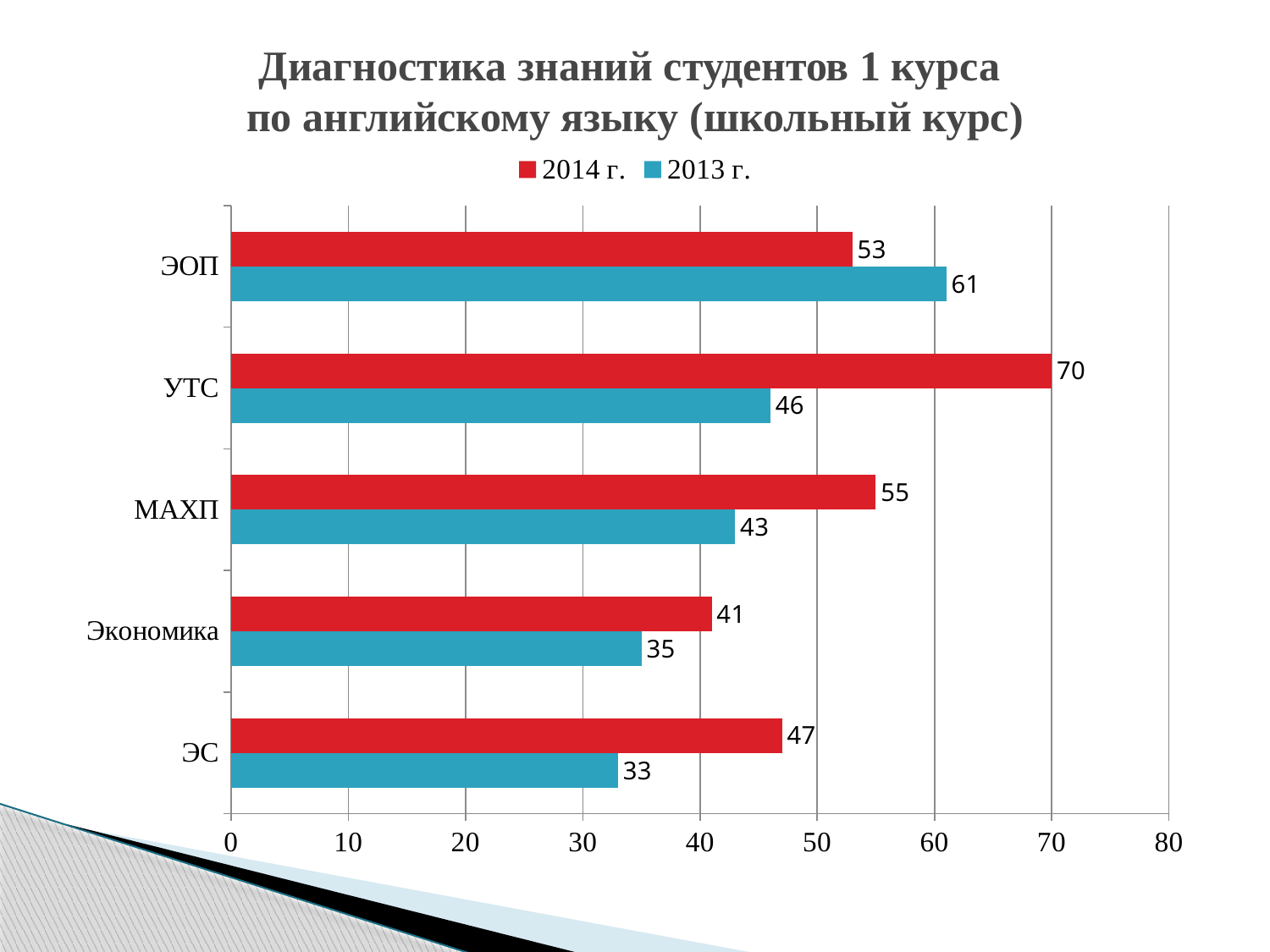
What kind of chart is shown on the slide? bar chart How many categories are shown on the chart? 5 Is the value for МАХП in the 2014 г. series greater or less than 50? greater What is the difference between the 2014 г. and 2013 г. values for УТС? 24 Which is larger for ЭОП: the 2014 г. value or the 2013 г. value? 2013 г. What is the value for УТС in the 2014 г. series? 70 What is the value for Экономика in the 2013 г. series? 35 How many series does the legend list? 2 What is the value for ЭОП in the 2013 г. series? 61 Which category has the lowest value in the 2013 г. series? ЭС Which category has the highest value in the 2014 г. series? УТС Which colour represents the 2013 г. series? blue